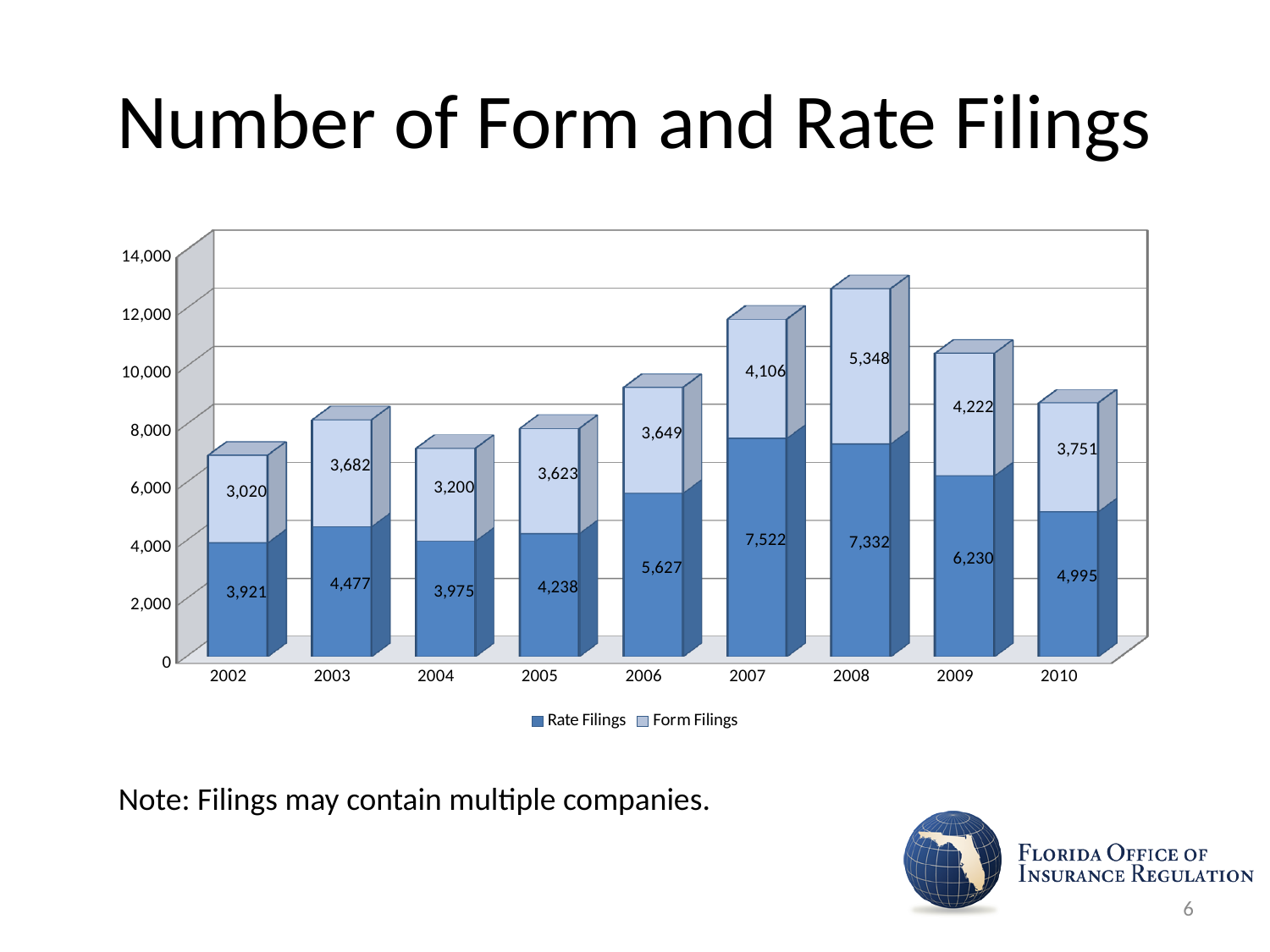
Which year has the highest number of Form Filings? 2008 Which year has the lowest number of Rate Filings? 2002 What is the total number of filings (Rate plus Form) in 2002? 6,941 What is the difference between Form Filings in 2008 and Form Filings in 2007? 1,242 How many years are shown on the x axis? 9 What is the value for Form Filings in 2010? 3,751 What kind of chart is shown on the slide? Stacked bar chart How many series does the legend list? 2 What is the total number of filings (Rate plus Form) in 2008? 12,680 What is the title of the chart? Number of Form and Rate Filings Which is larger, Rate Filings in 2009 or Rate Filings in 2010? Rate Filings in 2009 What is the value for Rate Filings in 2007? 7,522